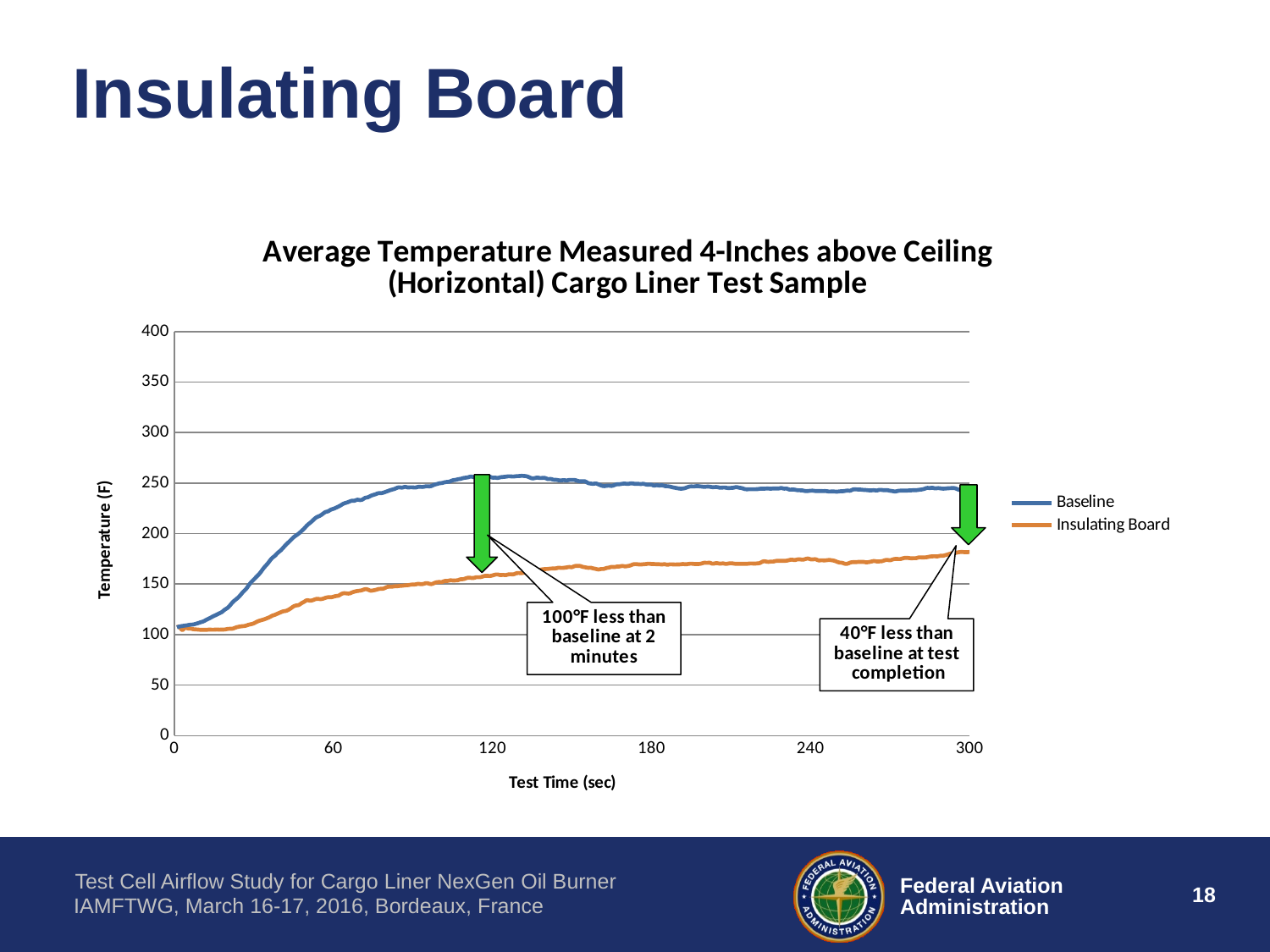
How many series does the legend list? 2 What is the label of the y axis? Temperature (F) According to the annotation, how much lower than the baseline is the Insulating Board temperature at test completion? 40°F What kind of chart is shown on the slide? line chart What is the label of the x axis? Test Time (sec) According to the annotation, how much lower than the baseline is the Insulating Board temperature at 2 minutes? 100°F What is the title of the chart? Average Temperature Measured 4-Inches above Ceiling (Horizontal) Cargo Liner Test Sample Does the Insulating Board series generally rise or fall as test time increases? rise Which series is drawn in orange? Insulating Board Is the Insulating Board value at 300 seconds greater or less than 200? less Is the Baseline value at 120 seconds greater or less than 200? greater At 120 seconds, which series has the higher temperature, Baseline or Insulating Board? Baseline